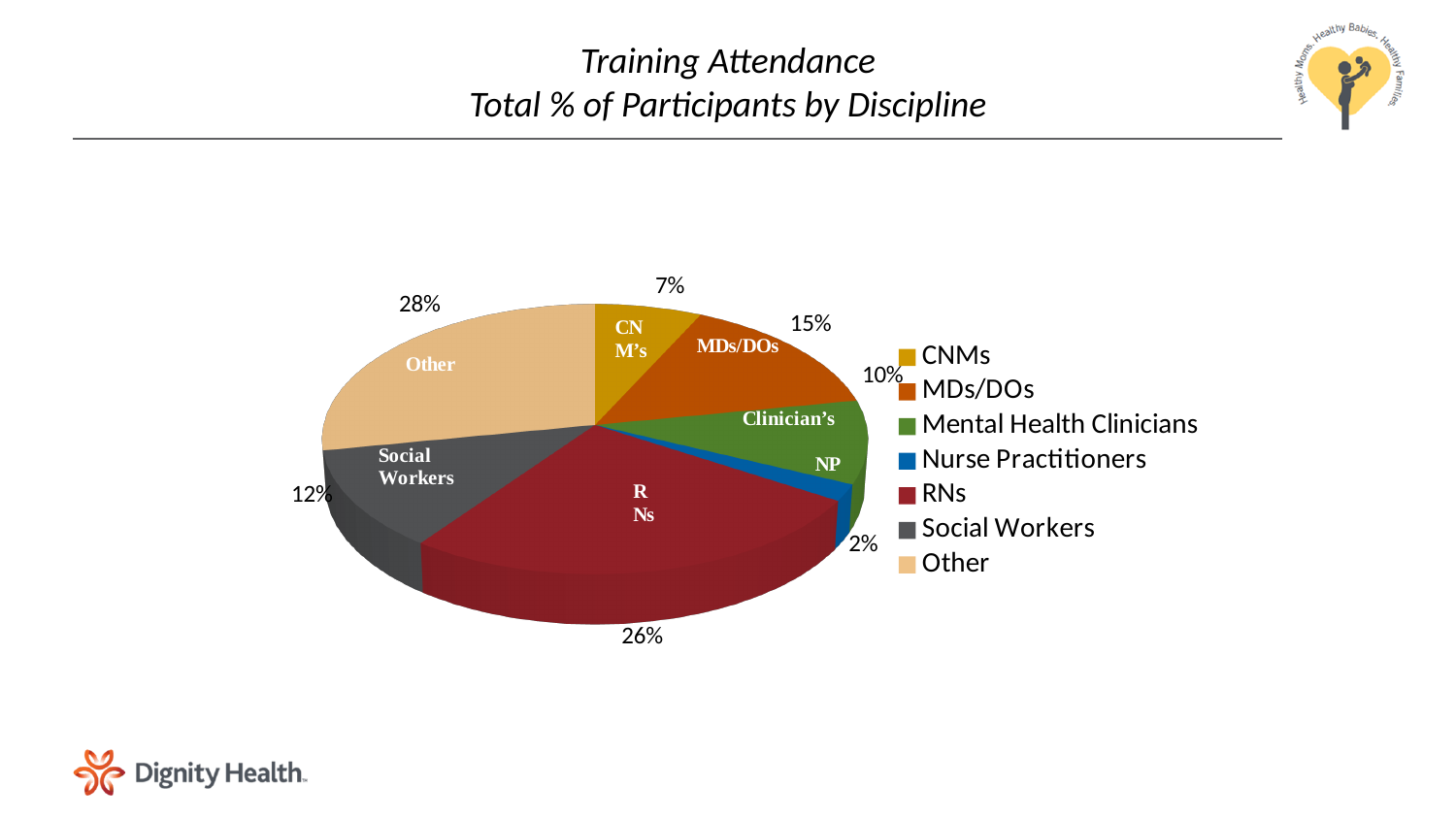
What kind of chart is shown on the slide? Pie chart What percentage of participants were CNMs? 7% What is the title of the chart? Training Attendance Total % of Participants by Discipline What percentage of participants were MDs/DOs? 15% How many percentage points larger is the RNs share than the Social Workers share? 14 Which is larger, the share for MDs/DOs or the share for Mental Health Clinicians? MDs/DOs What percentage of participants were RNs? 26% What percentage of participants were Social Workers? 12% How many disciplines does the legend list? 7 Which discipline has the smallest share of participants? Nurse Practitioners What percentage of participants were Nurse Practitioners? 2% Which discipline has the largest share of participants? Other